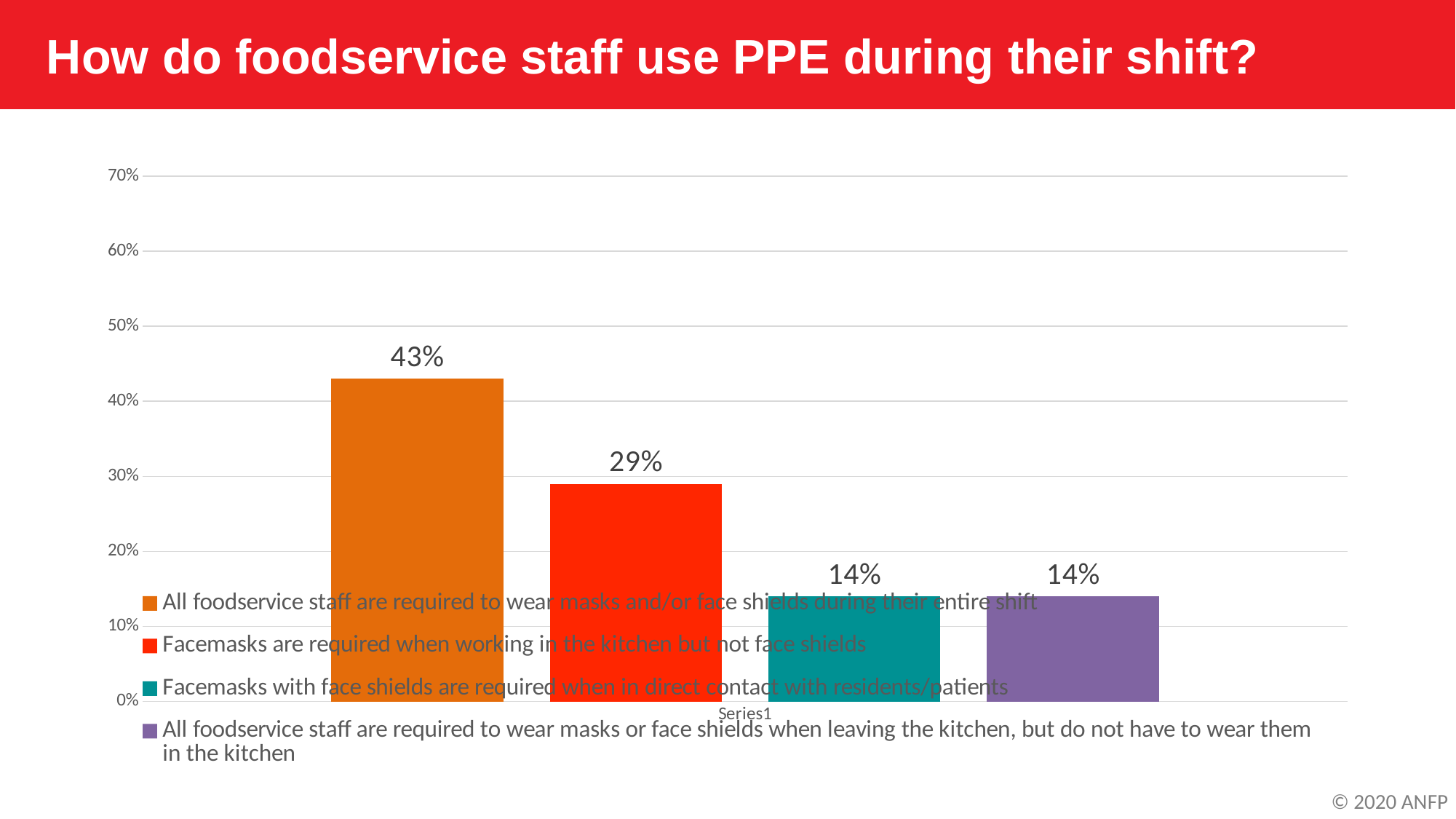
Which is larger: the share for facemasks required in the kitchen but not face shields, or the share for masks or face shields required only when leaving the kitchen? Facemasks are required when working in the kitchen but not face shields What is the title of the slide? How do foodservice staff use PPE during their shift? What kind of chart is shown on the slide? Bar chart Which response option has the highest percentage? All foodservice staff are required to wear masks and/or face shields during their entire shift What percentage of respondents said all foodservice staff are required to wear masks and/or face shields during their entire shift? 43% Do the bar values rise or fall from left to right? Fall What percentage of respondents said facemasks are required when working in the kitchen but not face shields? 29% How many bars are plotted in the chart? 4 Is the value for the orange bar greater or less than 40%? greater How many entries does the legend list? 4 What is the difference in percentage points between the orange bar (43%) and the red bar (29%)? 14 What percentage of respondents said facemasks with face shields are required when in direct contact with residents/patients? 14%